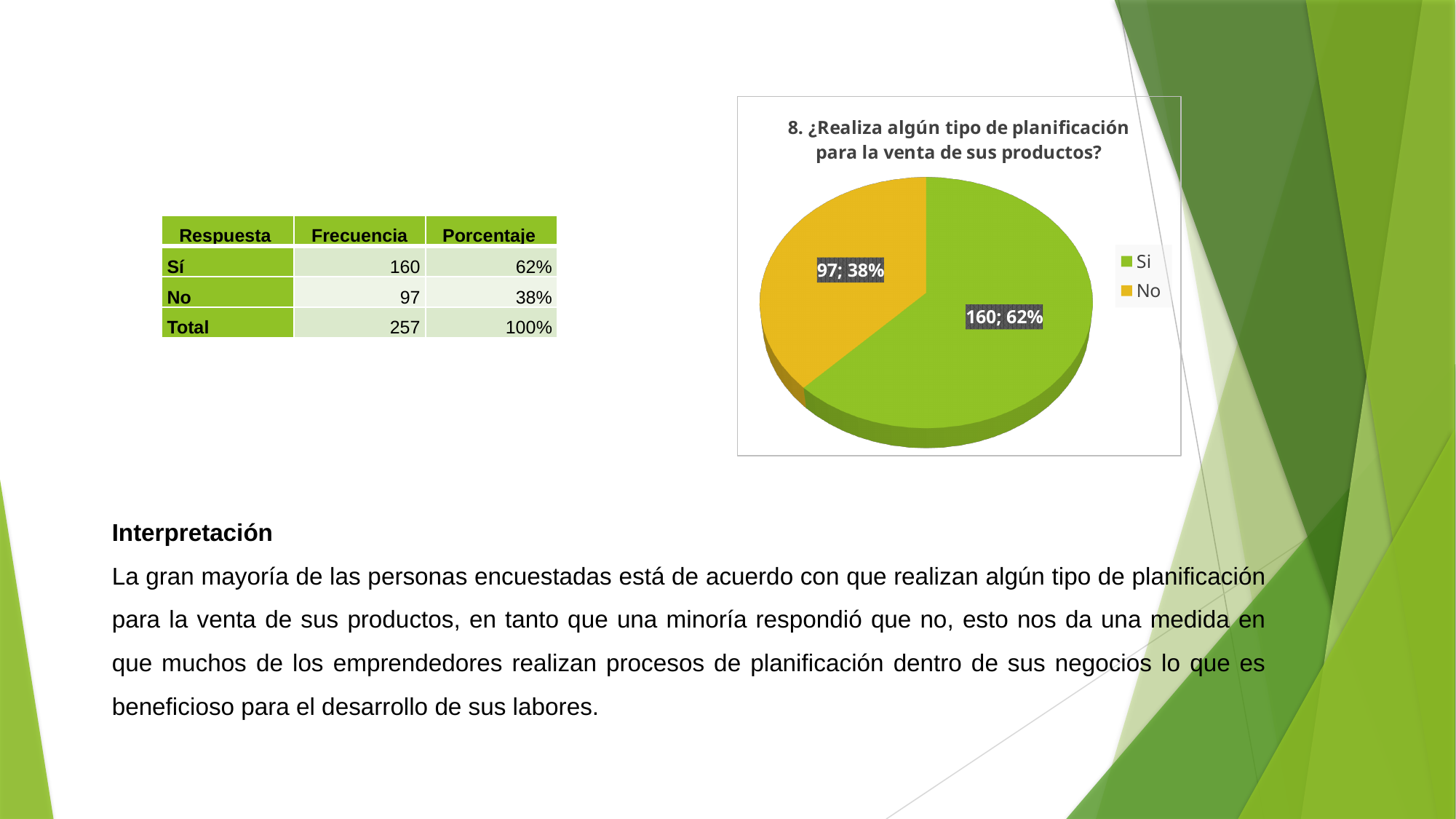
What percentage share of the pie does the 'Si' slice represent? 62% What is the title of the pie chart? 8. ¿Realiza algún tipo de planificación para la venta de sus productos? What is the frequency value shown for the 'Si' slice in the pie chart? 160 Which slice of the pie chart is the largest? Si What kind of chart is shown on the slide? pie chart What is the difference between the 'Si' and 'No' frequency values in the pie chart? 63 How many slices does the pie chart have? 2 What percentage share of the pie does the 'No' slice represent? 38% What is the frequency value shown for the 'No' slice in the pie chart? 97 Which colour represents the 'No' slice in the pie chart? yellow/orange How many entries does the legend of the pie chart list? 2 Which slice of the pie chart is the smallest? No